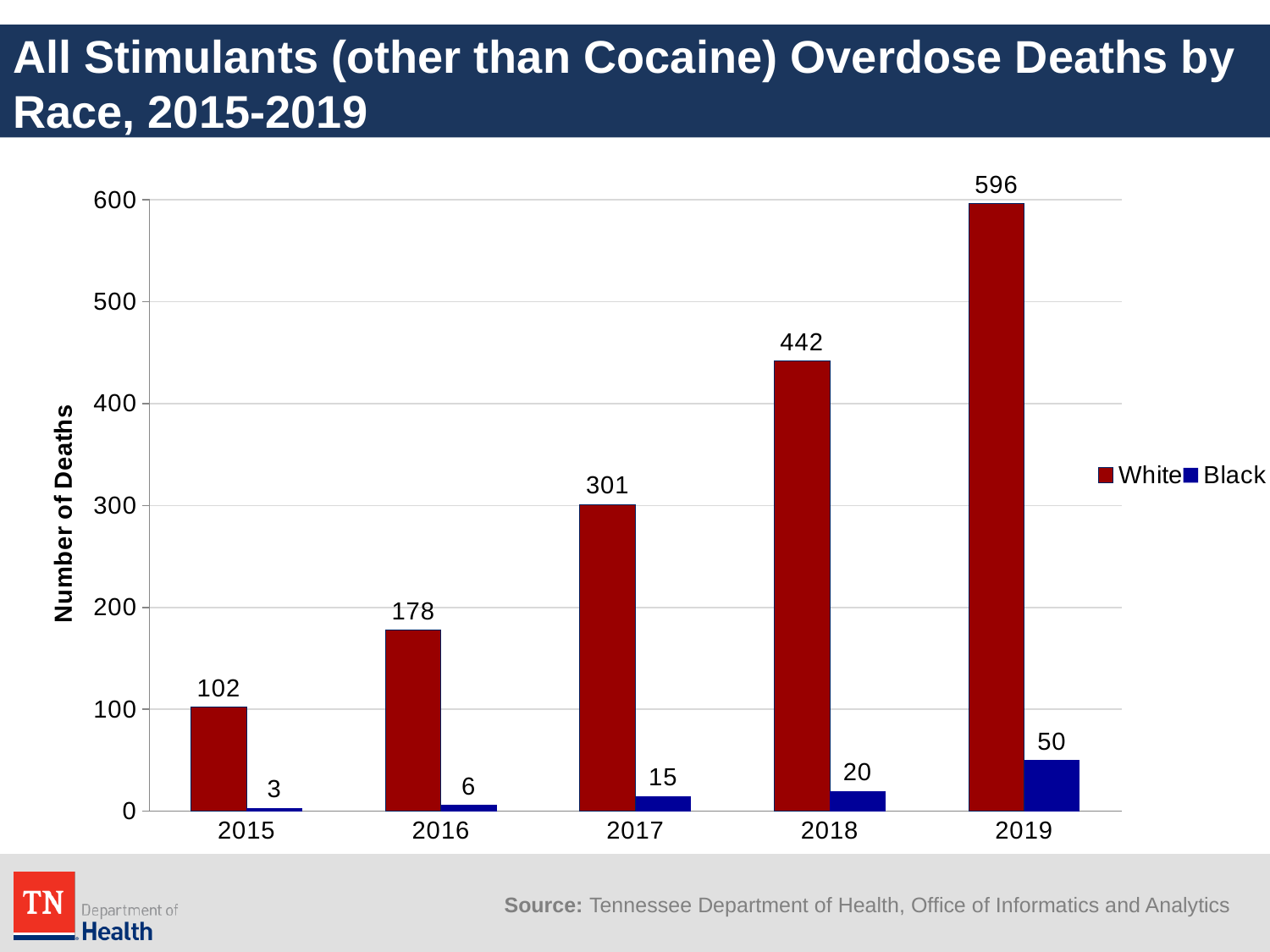
What kind of chart is shown on the slide? Bar chart Do the White deaths rise or fall from 2015 to 2019? Rise What is the number of deaths for Black individuals in 2019? 50 In which year was the number of deaths for Black individuals lowest? 2015 In which year was the number of deaths for White individuals highest? 2019 How many years are shown on the x axis? 5 How many overdose deaths among White individuals were recorded in 2017? 301 How many series does the legend list? 2 Which is larger: White deaths in 2016 or White deaths in 2017? White deaths in 2017 Is the value for White deaths in 2018 greater or less than 400? greater By how much did White deaths increase from 2015 to 2016? 76 What is the difference between White and Black deaths in 2018? 422